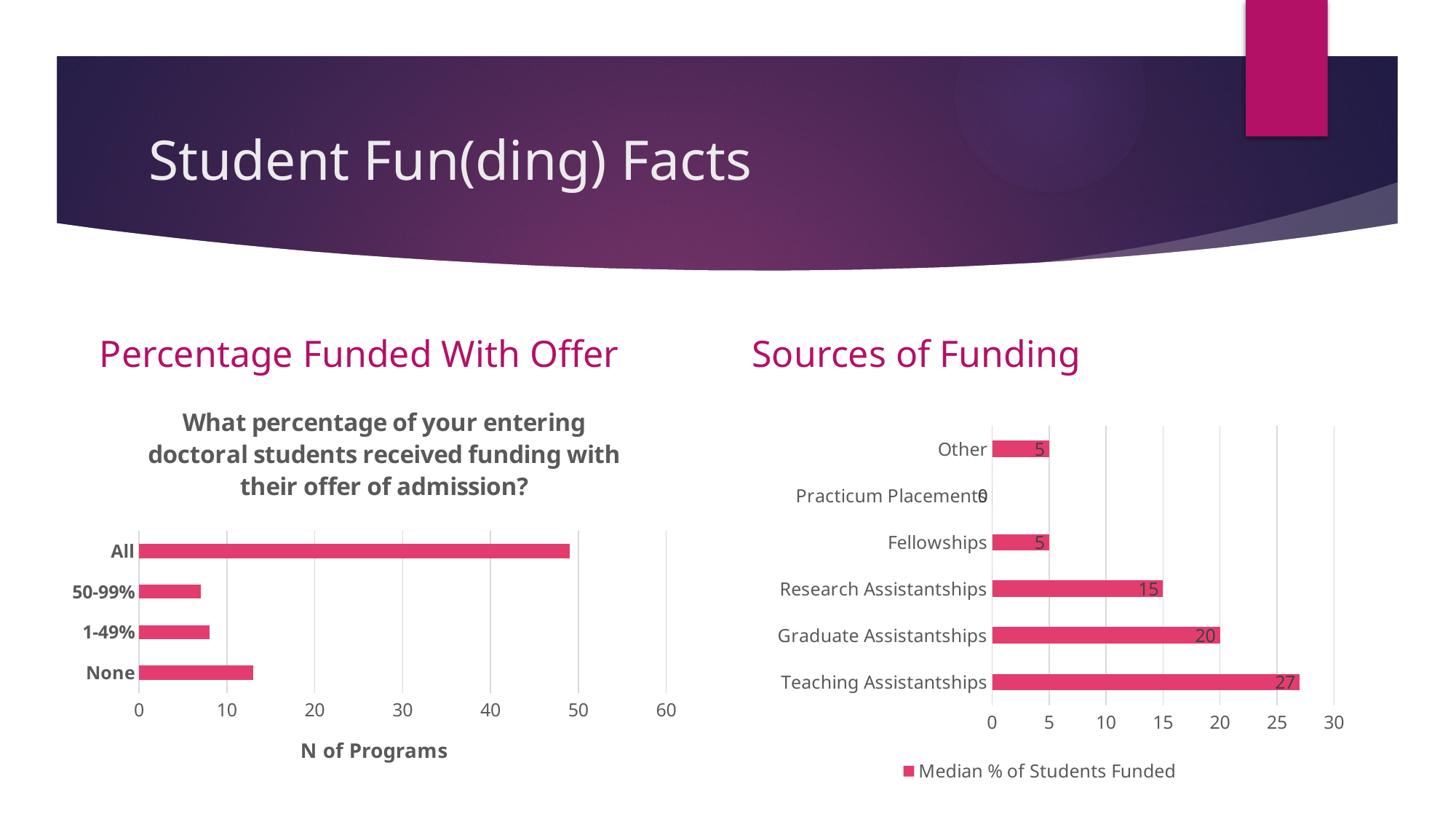
In the Sources of Funding chart, what is the difference between Teaching Assistantships and Graduate Assistantships? 7 In the Sources of Funding chart, which funding source has the lowest value? Practicum Placements How many series does the legend of the Sources of Funding chart list? 1 In the Sources of Funding chart, what is the value for Practicum Placements? 0 In the Sources of Funding chart, which is larger: Graduate Assistantships or Fellowships? Graduate Assistantships In the left chart about percentage funded with offer, is the value for None greater or less than 10? greater What kind of chart is the left chart about percentage funded with offer? bar chart In the left chart about percentage funded with offer, which category has the highest number of programs? All In the Sources of Funding chart, what is the median % of students funded by Teaching Assistantships? 27 In the Sources of Funding chart, what is the value for Research Assistantships? 15 In the Sources of Funding chart, which funding source has the highest median % of students funded? Teaching Assistantships How many funding sources are shown in the Sources of Funding chart? 6